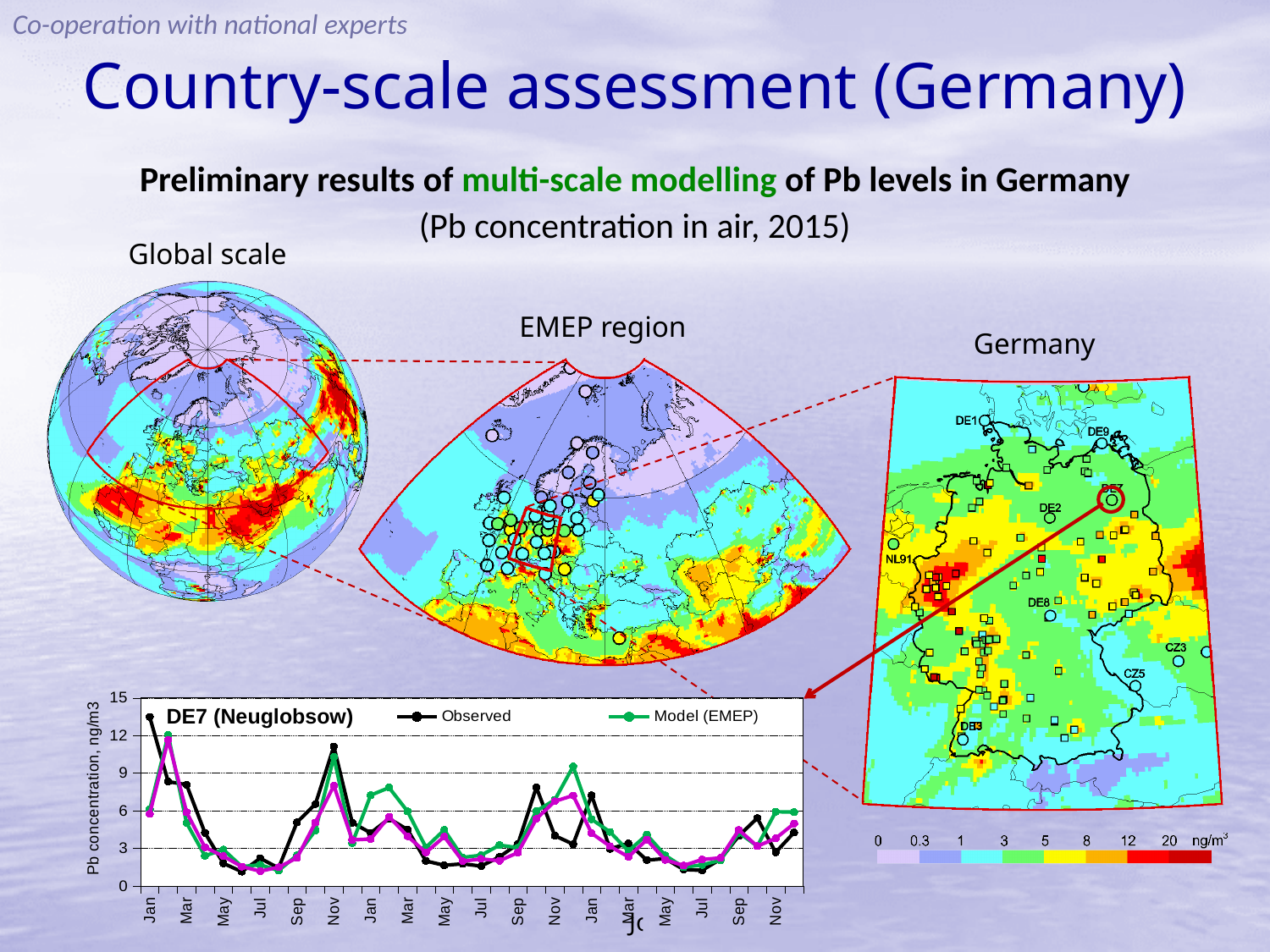
How many series does the legend of the DE7 (Neuglobsow) chart list? 2 In the DE7 (Neuglobsow) chart, which is larger at the first Jan: the Observed value or the Model (EMEP) value? Observed In the DE7 (Neuglobsow) chart, is the Observed value at the first Jan greater or less than 12? greater In the DE7 (Neuglobsow) chart, is the Observed value at the first Jul greater or less than 3? less In the DE7 (Neuglobsow) chart, is the Model (EMEP) value at the first May greater or less than 6? less In the DE7 (Neuglobsow) chart, does the Observed line rise or fall from the first Jan to the first Jul? fall What kind of chart is the DE7 (Neuglobsow) chart at the bottom left of the slide? line chart What is the title shown inside the line chart at the bottom left of the slide? DE7 (Neuglobsow) In the DE7 (Neuglobsow) chart, what colour is the Model (EMEP) line? green In the DE7 (Neuglobsow) chart, what is the highest value shown on the y axis? 15